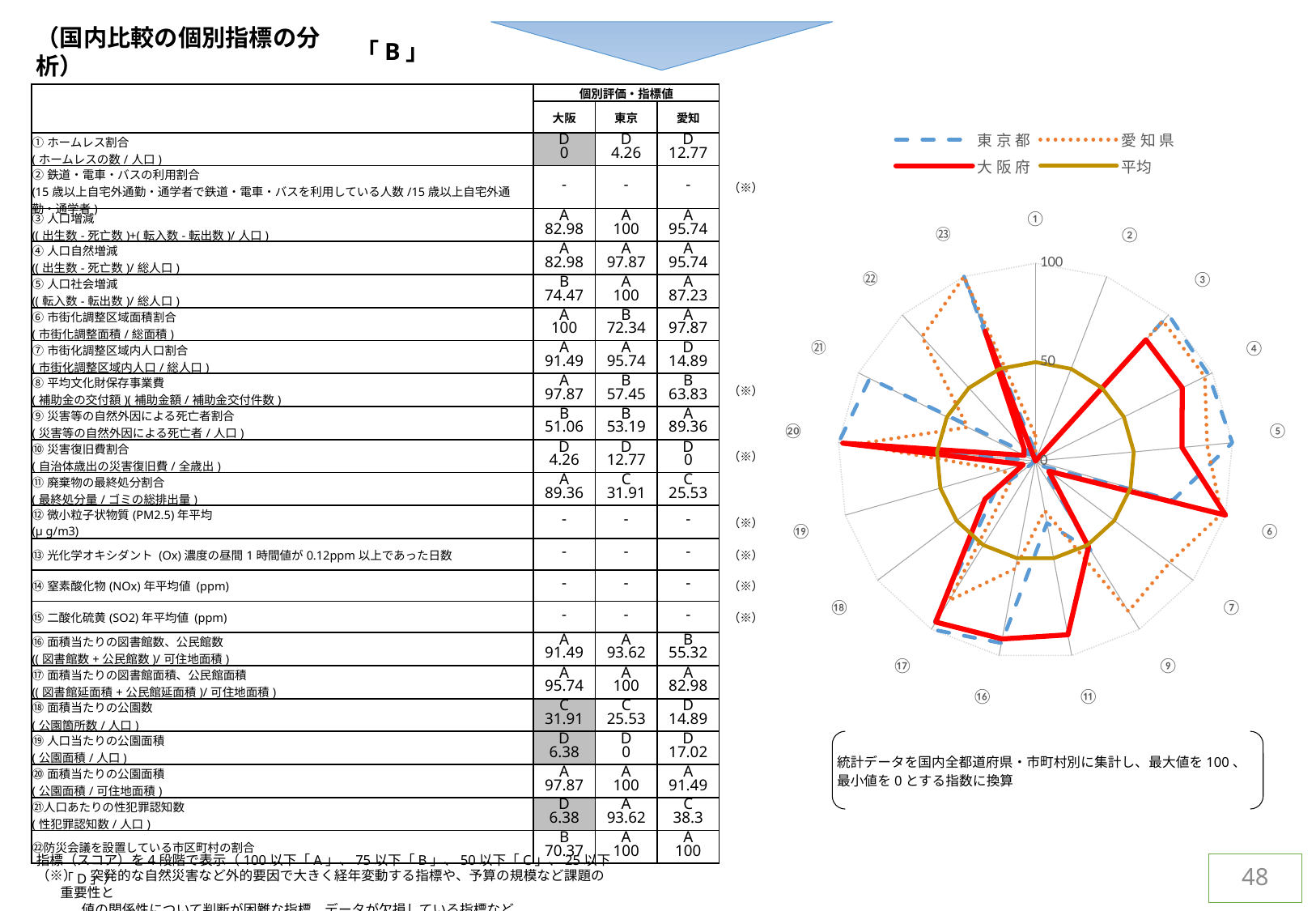
What is the maximum value shown on the radar chart's axis scale? 100 In the radar chart legend, which series is drawn as a solid red line? 大阪府 For indicator ⑦, which is larger, the 大阪 value or the 愛知 value? 大阪 How many numbered categories (axes) does the radar chart have? 17 On the radar chart, is the value for 大阪府 at category ⑳ greater or less than 50? greater For indicator ⑪ 廃棄物の最終処分割合, which of the three prefectures has the highest value? 大阪 How many series does the legend of the radar chart list? 4 What kind of chart is shown on the right side of the slide? radar chart According to the table, what is the 大阪 value for indicator ⑥ 市街化調整区域面積割合? 100 According to the table, what is the 愛知 value for indicator ⑦ 市街化調整区域内人口割合? 14.89 On the radar chart, is the value for 大阪府 at category ⑲ greater or less than 50? less On the radar chart, is the value for 愛知県 at category ⑦ greater or less than 50? greater